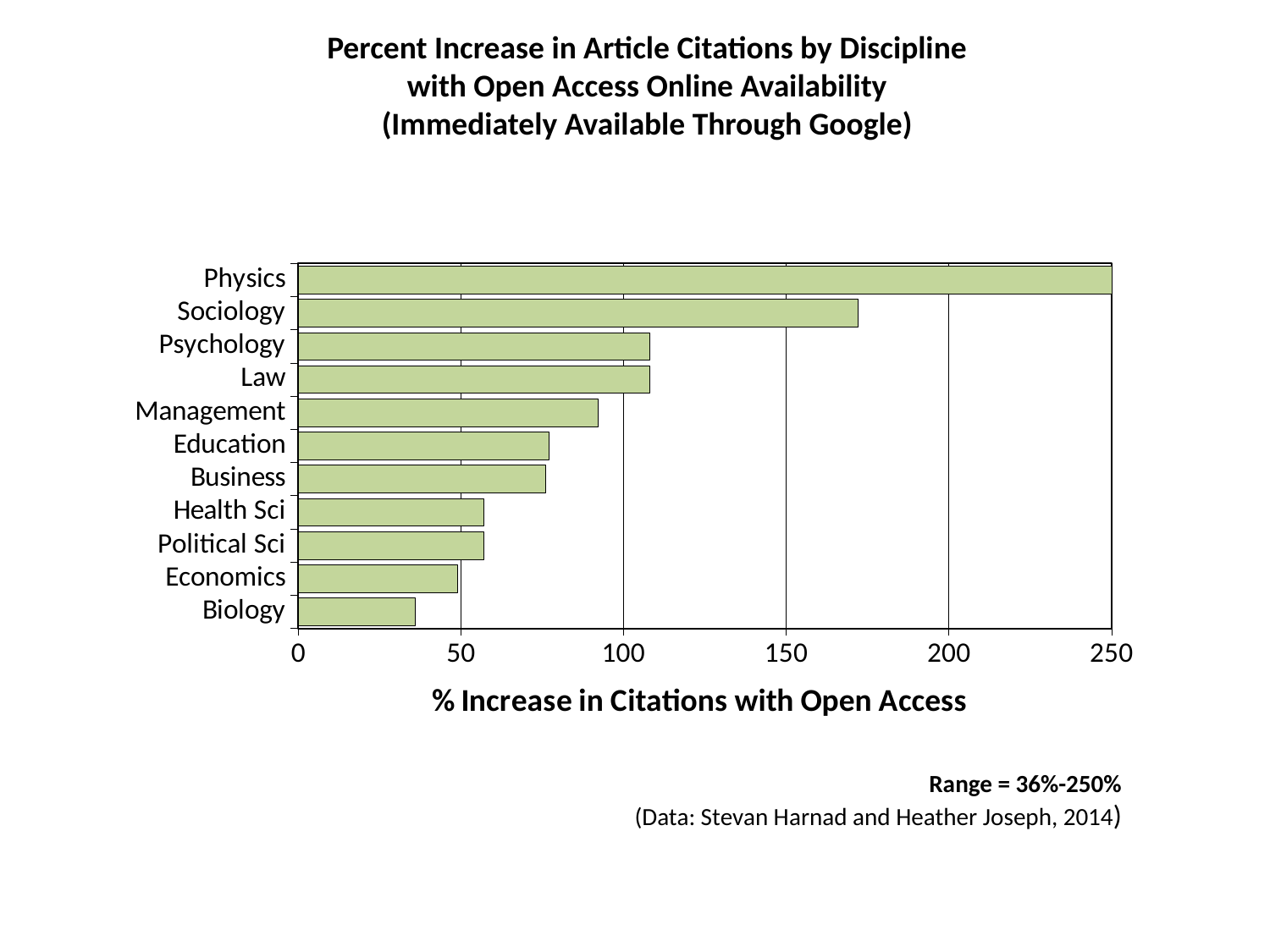
Which discipline has the lowest percent increase in citations? Biology Is the value for Sociology greater or less than 150? greater Which discipline has the highest percent increase in citations? Physics What is the label of the horizontal axis? % Increase in Citations with Open Access Which has a larger percent increase in citations, Management or Business? Management Which has a larger percent increase in citations, Sociology or Psychology? Sociology What is the percent increase in citations for Physics? 250 What kind of chart is shown on the slide? bar chart How many disciplines are plotted in the chart? 11 Is the value for Biology greater or less than 50? less Is the value for Education greater or less than 50? greater